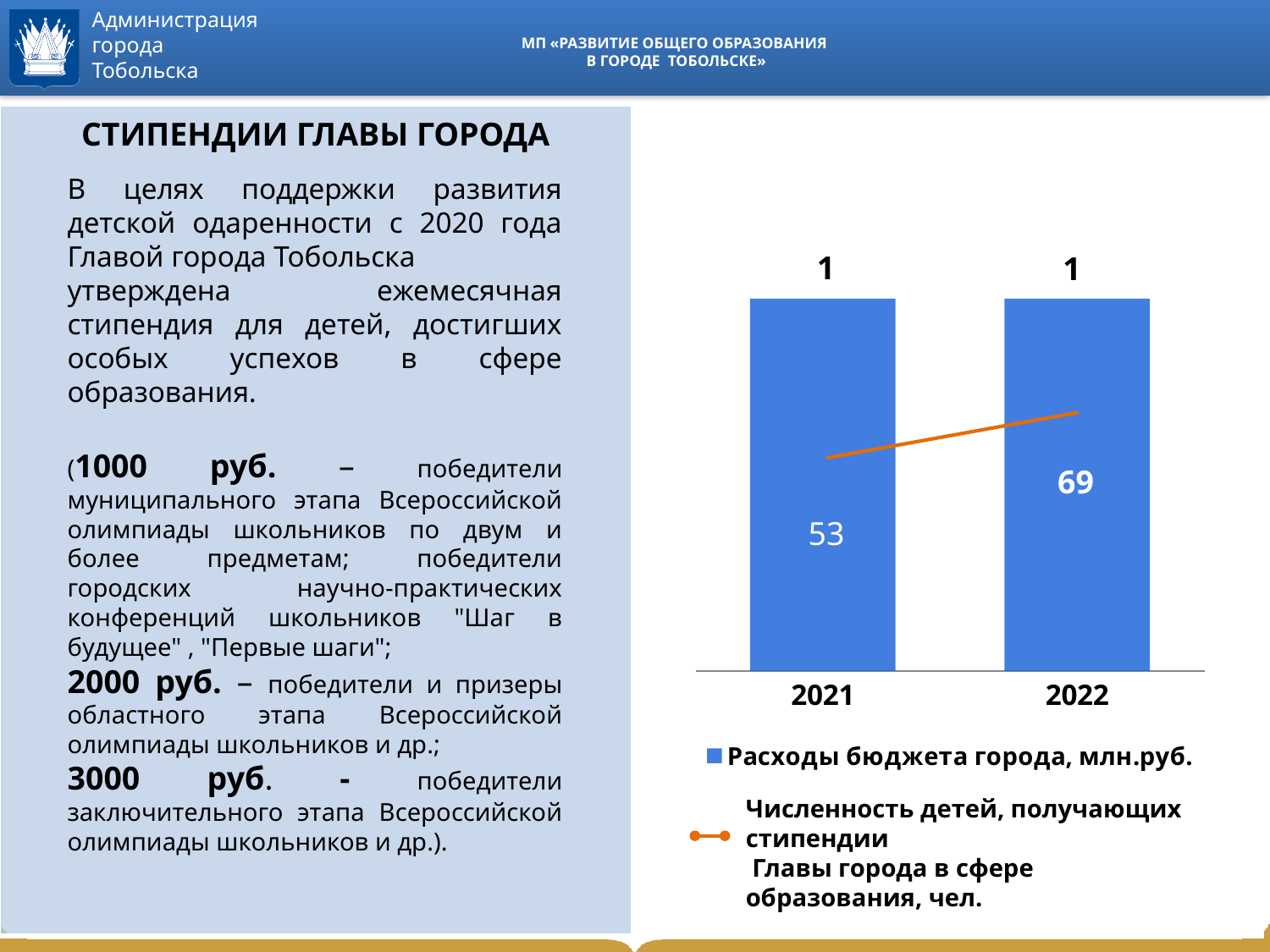
How many children received the Head of City scholarship in 2022 according to the line series? 69 In which year was the number of children receiving scholarships higher? 2022 By how much did the number of children receiving scholarships increase from 2021 to 2022? 16 Does the number of children receiving scholarships rise or fall from 2021 to 2022? rise How many years (categories) are shown on the x axis of the chart? 2 What is the value of 'Расходы бюджета города, млн.руб.' for 2021? 1 What is the value of 'Расходы бюджета города, млн.руб.' for 2022? 1 What colour are the bars representing 'Расходы бюджета города, млн.руб.'? blue How many series does the chart legend list? 2 How many children received the Head of City scholarship in 2021 according to the line series? 53 In which year was the number of children receiving scholarships lower? 2021 Which is larger: the number of scholarship recipients in 2021 or in 2022? 2022